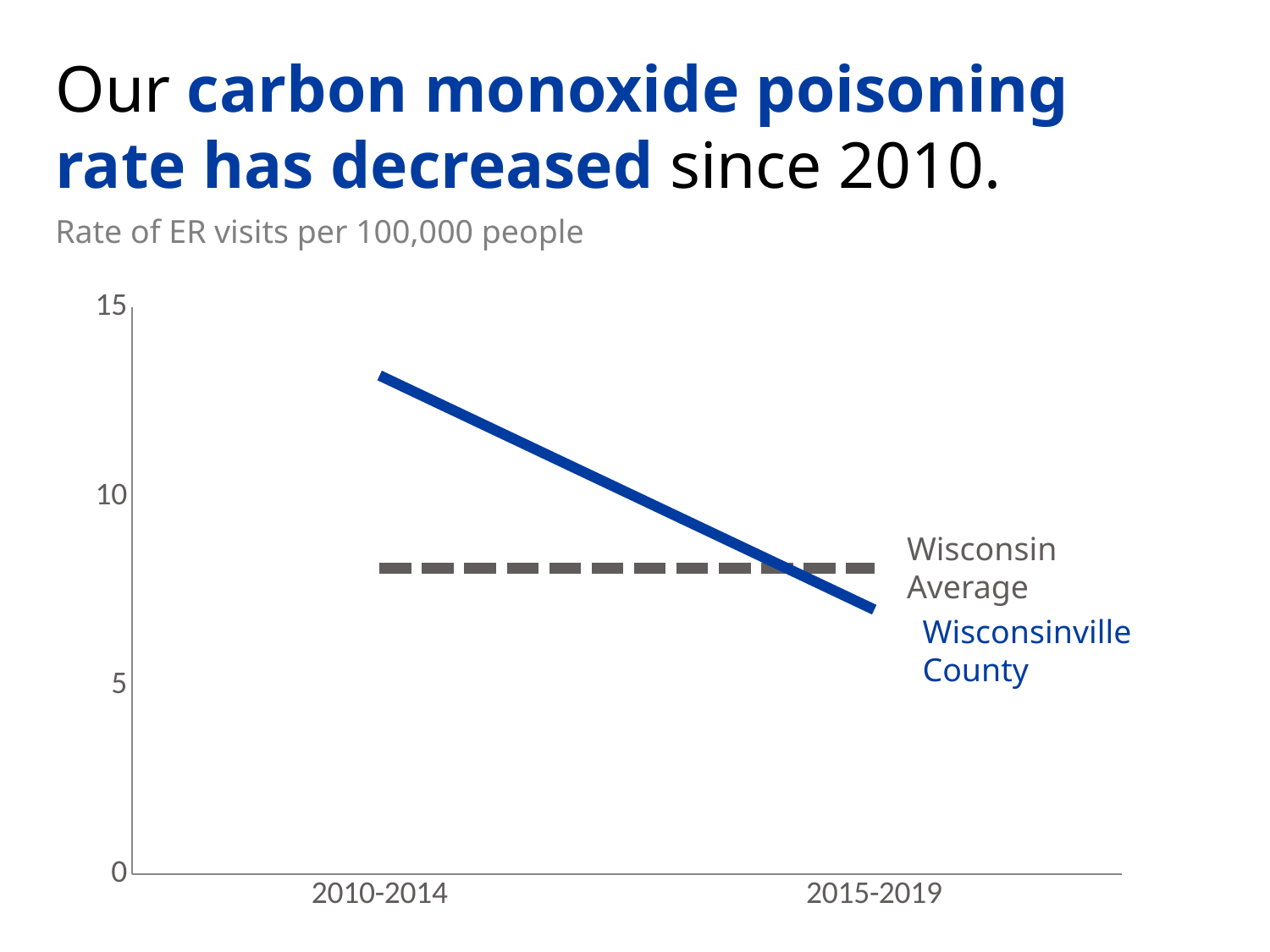
Is the Wisconsin Average value greater or less than 10? less What does the subtitle say the chart measures? Rate of ER visits per 100,000 people Is the Wisconsinville County value for 2015-2019 greater or less than 10? less How many time periods are shown on the x axis? 2 In 2015-2019, which is higher: Wisconsinville County or the Wisconsin Average? Wisconsin Average In 2010-2014, which is higher: Wisconsinville County or the Wisconsin Average? Wisconsinville County In which period is the Wisconsinville County rate highest? 2010-2014 Is the Wisconsinville County value for 2010-2014 greater or less than 10? greater Does the Wisconsinville County line rise or fall from 2010-2014 to 2015-2019? fall What kind of chart is shown on the slide? line chart How many series are plotted on the chart? 2